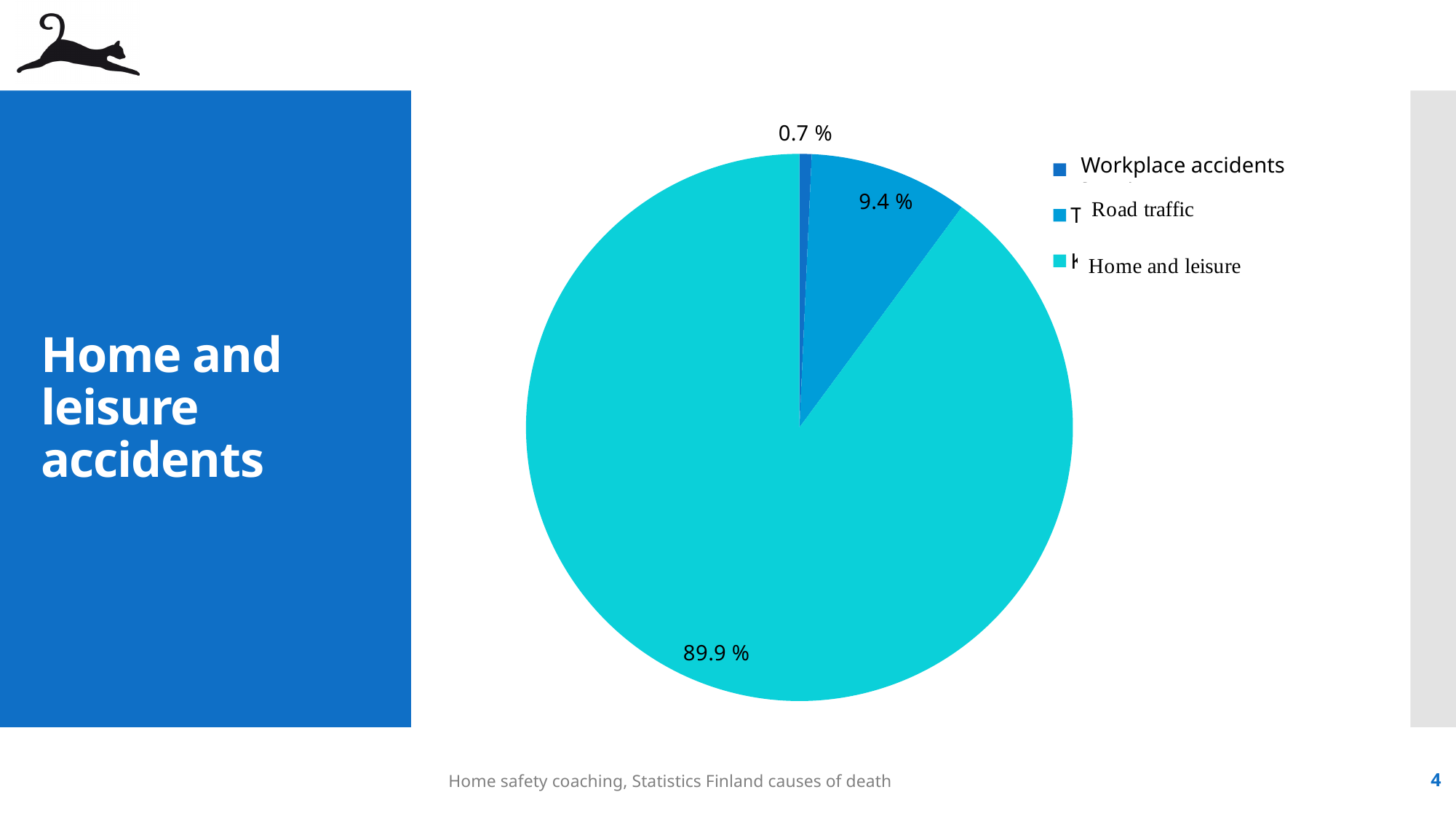
Which category has the largest slice of the pie? Home and leisure What is the difference in percentage points between Road traffic and Workplace accidents? 8.7 Which category has the smallest slice of the pie? Workplace accidents How many entries does the legend list? 3 Which is larger, the Road traffic slice or the Workplace accidents slice? Road traffic What share of the pie is Workplace accidents? 0.7 % What is the difference in percentage points between Home and leisure and Road traffic? 80.5 What kind of chart is shown on the slide? Pie chart What colour is the Home and leisure slice? Turquoise What share of the pie is Home and leisure? 89.9 % How many slices does the pie chart have? 3 What share of the pie is Road traffic? 9.4 %